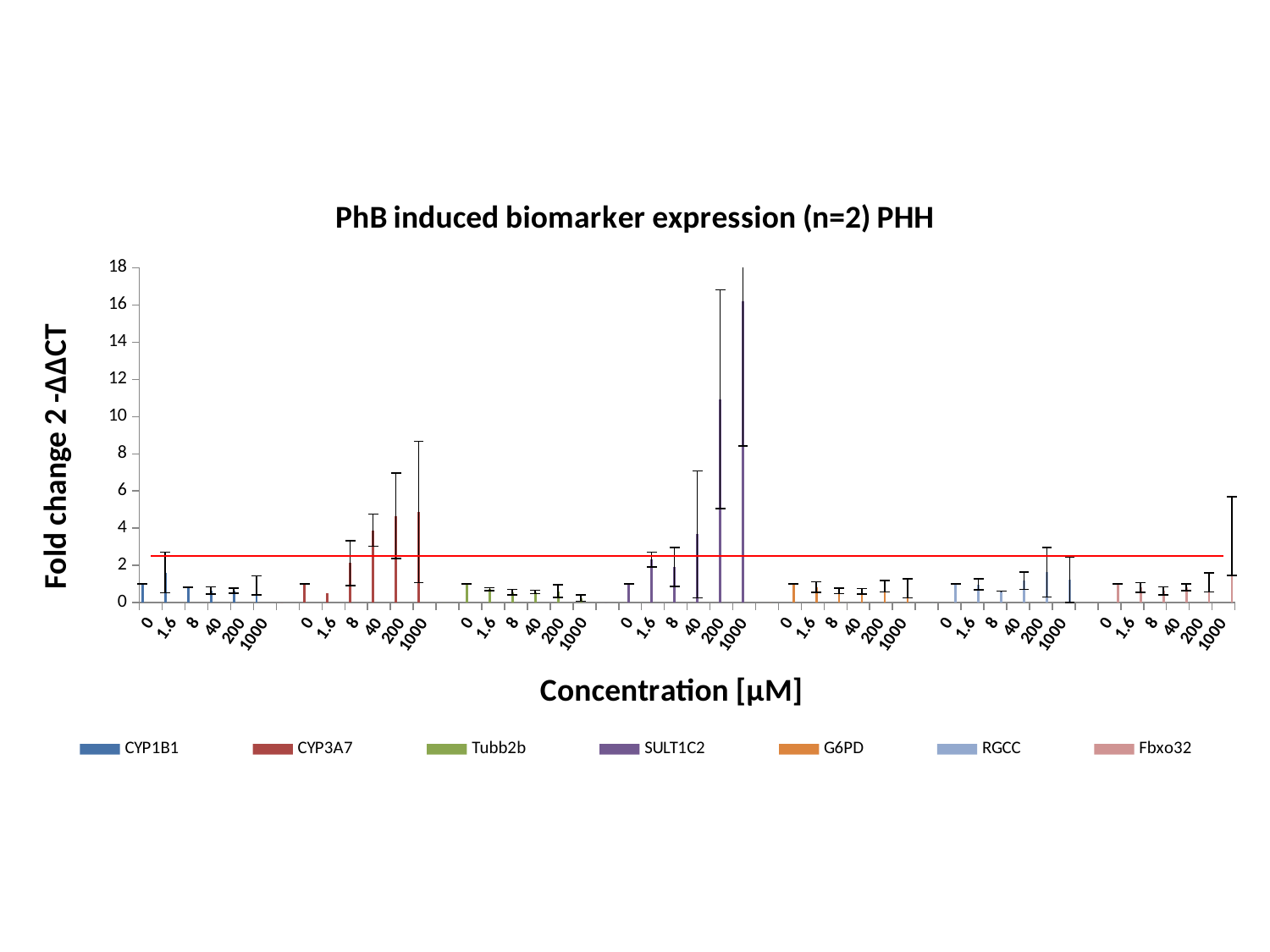
Is the value for CYP3A7 at 200 µM greater or less than 6? less What kind of chart is shown on the slide? bar chart How many concentration levels are plotted for each series? 6 Is the value for SULT1C2 at 200 µM greater or less than 8? greater How many series does the legend list? 7 Is the value for CYP1B1 at 0 µM greater or less than 2? less Do the SULT1C2 values generally rise or fall as concentration increases from 0 to 1000 µM? rise What is the label of the x axis? Concentration [µM] Which series has the tallest bar in the chart? SULT1C2 What is the title of the chart? PhB induced biomarker expression (n=2) PHH Which is larger, the value for SULT1C2 at 1000 µM or the value for CYP3A7 at 1000 µM? SULT1C2 at 1000 µM